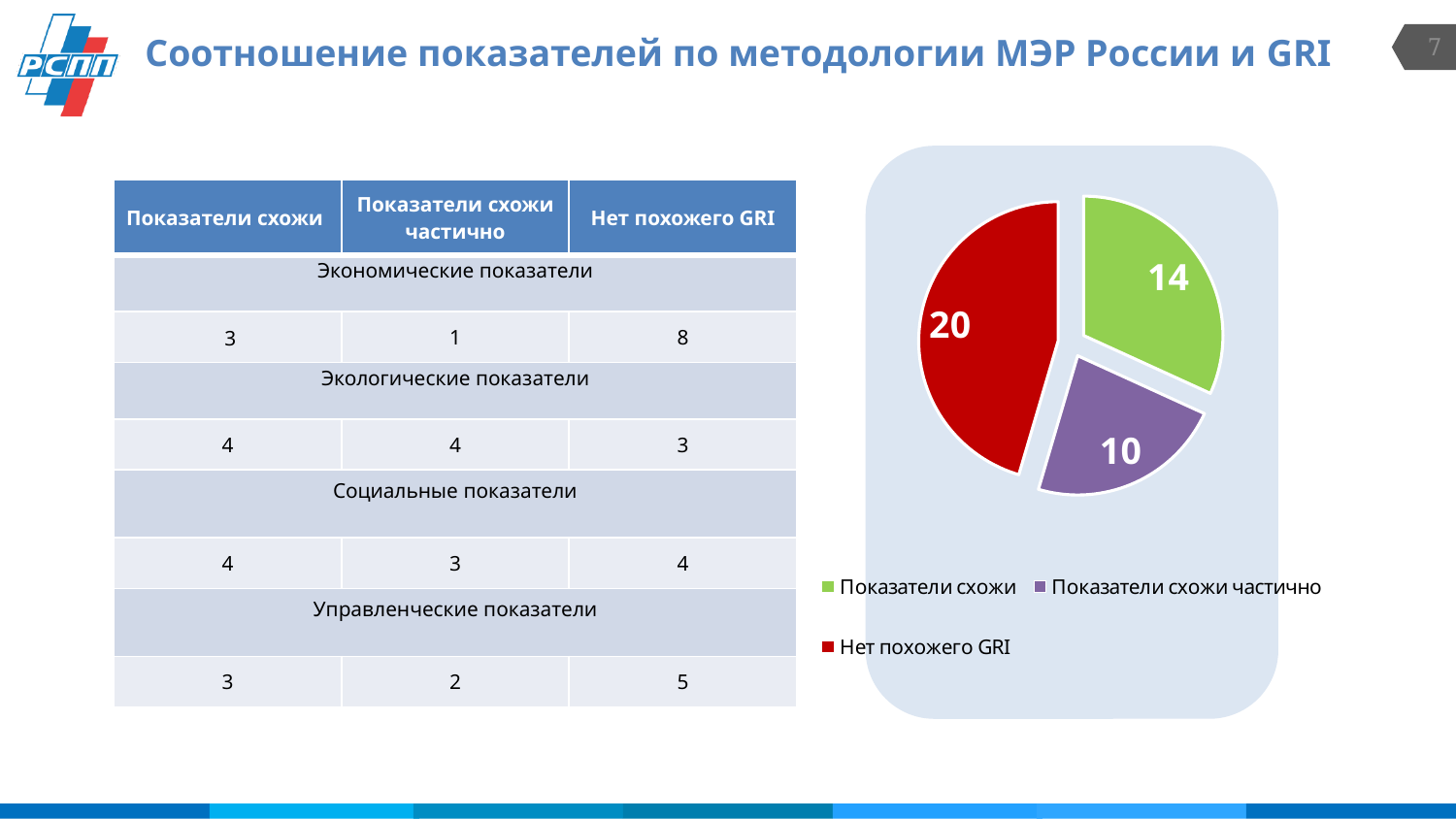
What type of chart is shown on the slide? Pie chart Which category has the smallest slice in the pie chart? Показатели схожи частично What is the total of all slice values in the pie chart? 44 What colour is the "Нет похожего GRI" slice in the pie chart? Red Which is larger in the pie chart: "Показатели схожи" or "Показатели схожи частично"? Показатели схожи What value is shown for the "Нет похожего GRI" slice of the pie chart? 20 What value is shown for the "Показатели схожи частично" slice of the pie chart? 10 How many entries does the legend of the pie chart list? 3 What is the difference between the "Нет похожего GRI" slice and the "Показатели схожи" slice in the pie chart? 6 What value is shown for the "Показатели схожи" slice of the pie chart? 14 How many slices does the pie chart have? 3 Which category has the largest slice in the pie chart? Нет похожего GRI